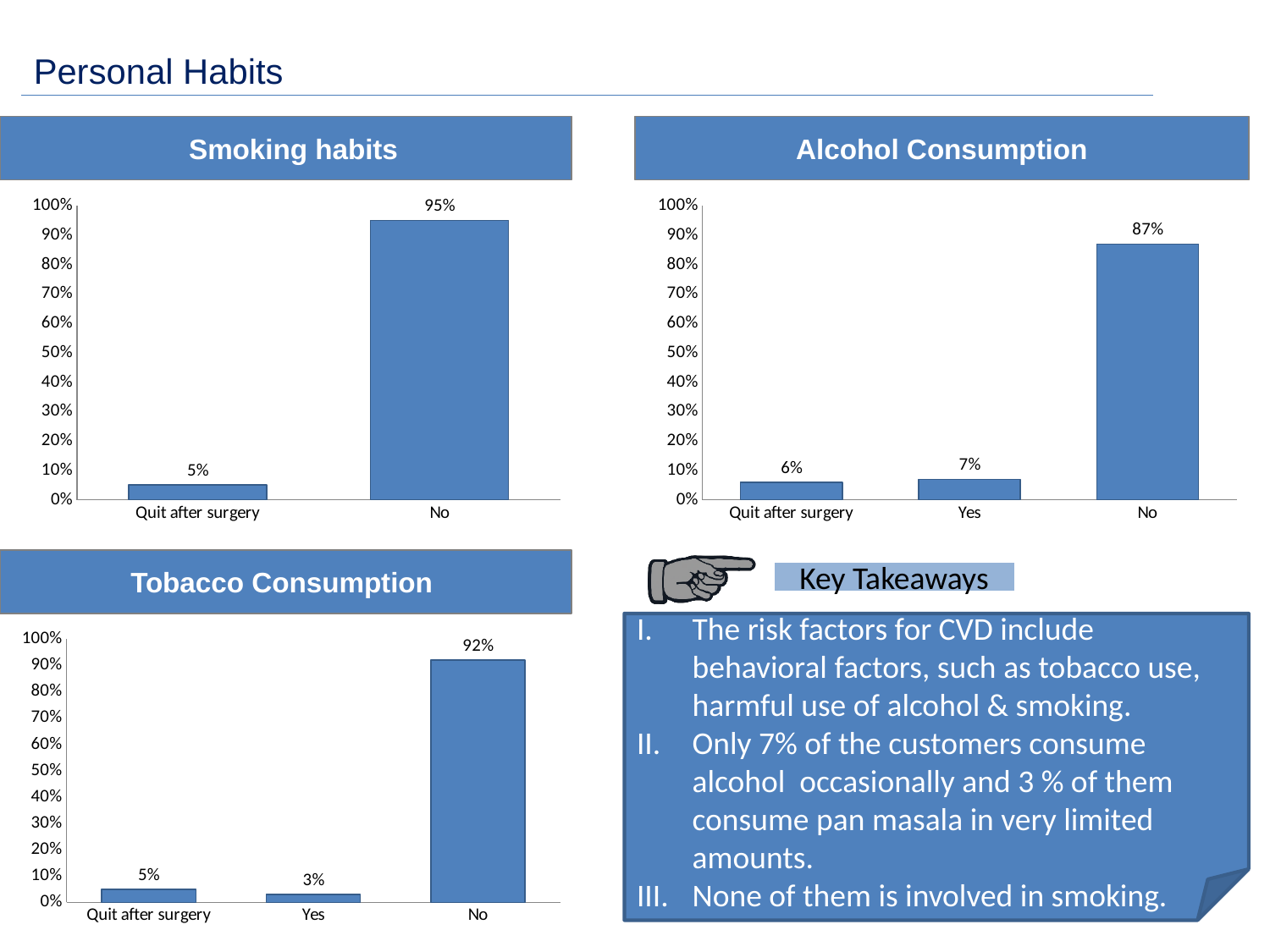
In the Tobacco Consumption chart, which is larger, the value for Quit after surgery or the value for Yes? Quit after surgery What type of chart is the Tobacco Consumption chart? Bar chart In the Alcohol Consumption chart, which category has the lowest value? Quit after surgery In the Smoking habits chart, what is the value for Quit after surgery? 5% In the Tobacco Consumption chart, what is the value for Yes? 3% In the Smoking habits chart, what is the difference between the values for No and Quit after surgery? 90% How many categories are shown in the Smoking habits chart? 2 In the Tobacco Consumption chart, which category has the highest value? No In the Alcohol Consumption chart, what is the value for Yes? 7% In the Alcohol Consumption chart, what is the value for No? 87% How many categories are shown in the Alcohol Consumption chart? 3 In the Smoking habits chart, what is the value for No? 95%